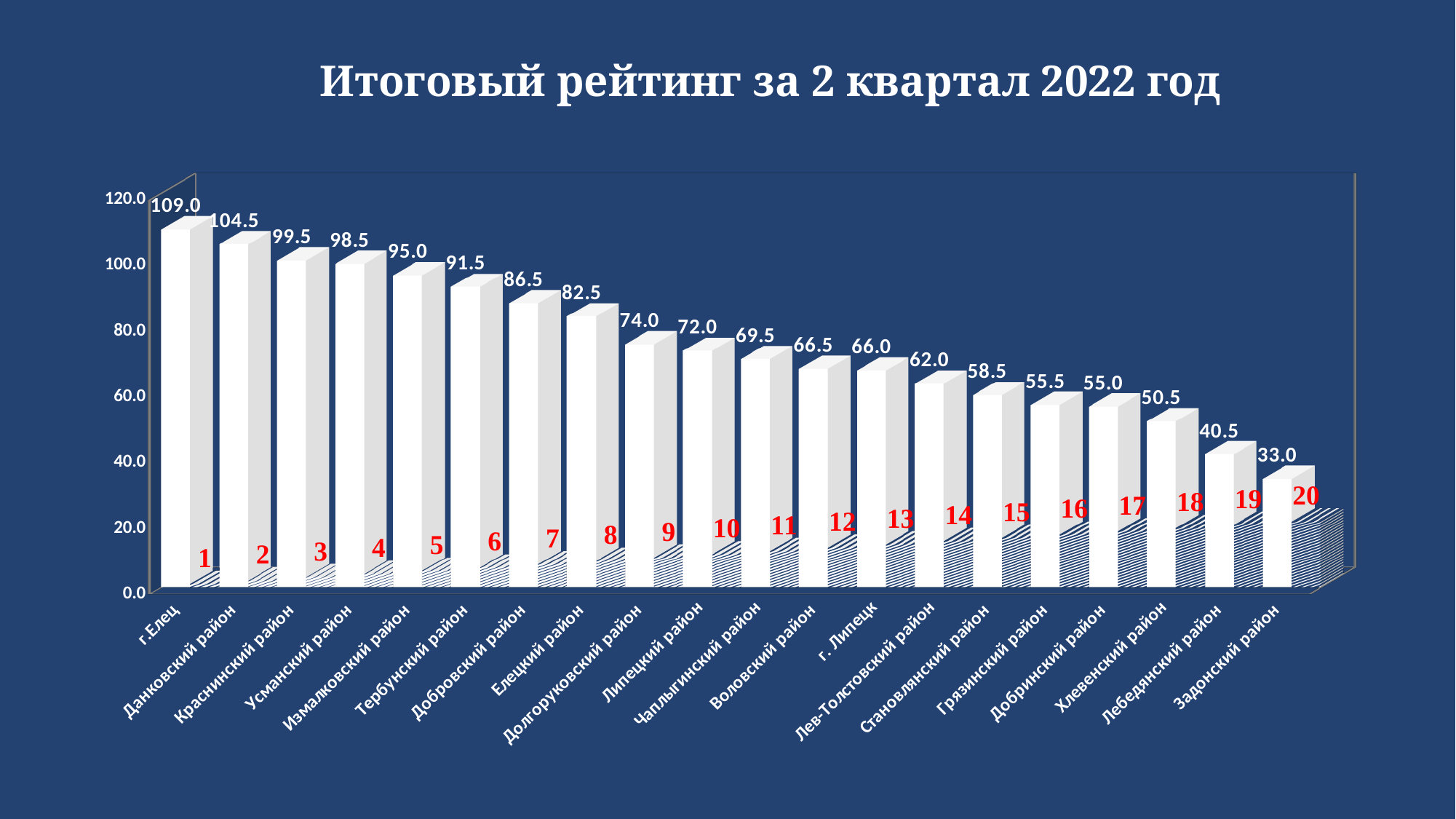
Do the values rise or fall from left to right along the x axis? fall How many categories are shown on the chart? 20 Which category has the lowest value? Задонский район What is the difference between the values for Данковский район and Краснинский район? 5.0 What rank number is printed in red on the bar for Добровский район? 7 What is the value for г.Елец? 109.0 Which category has the highest value? г.Елец What is the value for Задонский район? 33.0 What kind of chart is shown on the slide? bar chart What is the title of the chart? Итоговый рейтинг за 2 квартал 2022 год Which is larger, the value for Липецкий район or the value for г. Липецк? Липецкий район What is the value for Тербунский район? 91.5